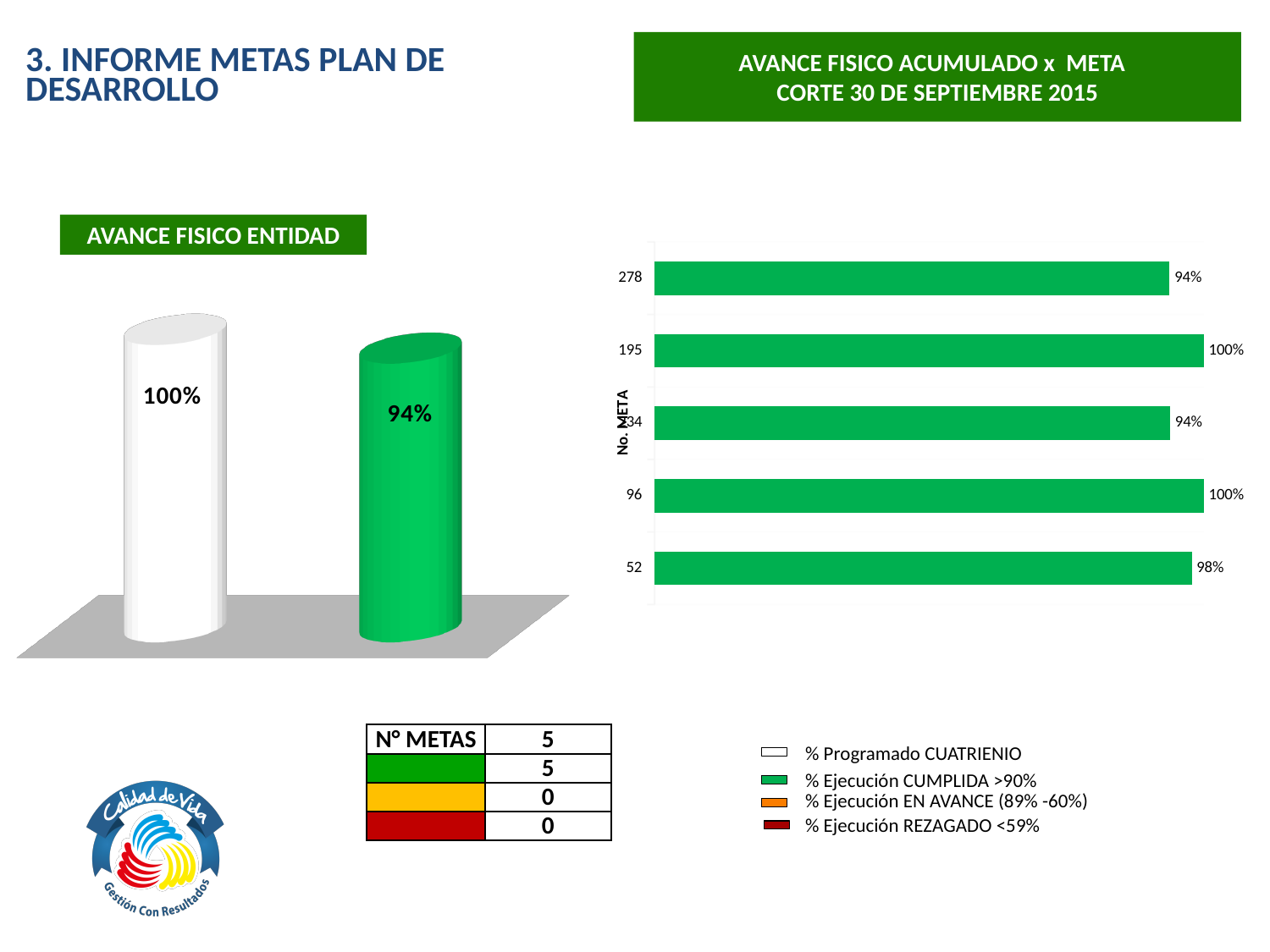
In the AVANCE FISICO ACUMULADO x META chart, which is larger, the value for meta 52 or the value for meta 278? meta 52 In the AVANCE FISICO ACUMULADO x META chart, what is the lowest value shown? 94% In the AVANCE FISICO ACUMULADO x META chart, what is the value for meta 195? 100% In the AVANCE FISICO ACUMULADO x META chart, how many metas (bars) are plotted? 5 In the AVANCE FISICO ACUMULADO x META chart, what is the label of the vertical axis? No. META In the AVANCE FISICO ACUMULADO x META chart, what is the value for meta 278? 94% In the AVANCE FISICO ACUMULADO x META chart, what is the difference between the values for meta 195 and meta 278? 6% In the AVANCE FISICO ACUMULADO x META chart, what is the value for meta 96? 100% In the AVANCE FISICO ENTIDAD chart, what value is shown on the white cylinder? 100% In the AVANCE FISICO ENTIDAD chart, what value is shown on the green cylinder? 94% In the AVANCE FISICO ACUMULADO x META chart, what is the value for meta 52? 98% What kind of chart is the AVANCE FISICO ACUMULADO x META chart? bar chart